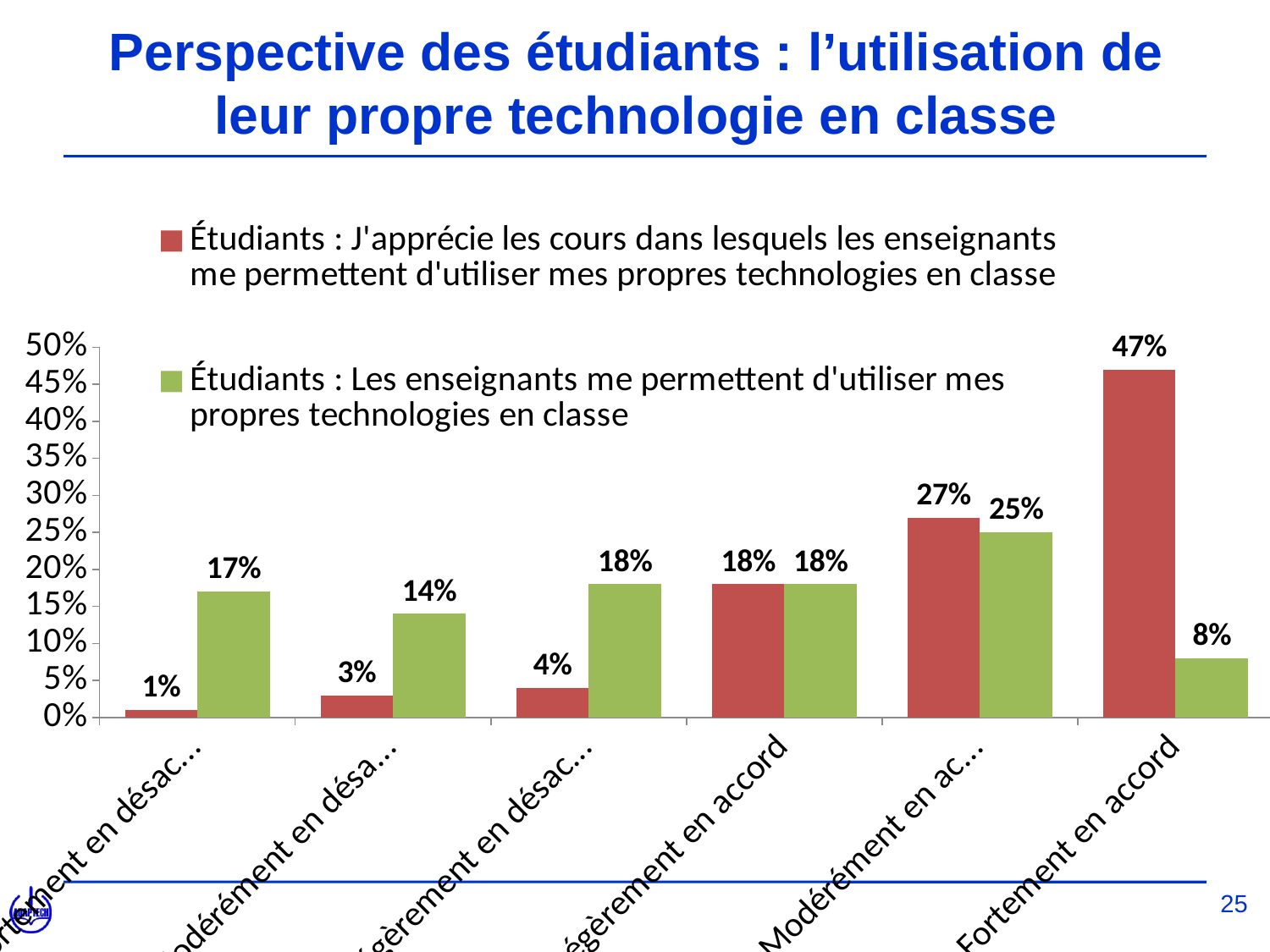
What type of chart is shown on the slide? bar chart What is the value for 'Fortement en accord' in the series 'Étudiants : J'apprécie les cours dans lesquels les enseignants me permettent d'utiliser mes propres technologies en classe'? 47% What is the highest value shown for the green series? 25% What is the value for 'Légèrement en accord' in the series 'Étudiants : J'apprécie les cours dans lesquels les enseignants me permettent d'utiliser mes propres technologies en classe'? 18% How many categories are shown along the x axis? 6 Do the values of the red series rise or fall from left to right along the x axis? rise For 'Fortement en accord', what is the difference between the red series value and the green series value? 39% How many series does the legend list? 2 What is the highest value shown for the red series? 47% What is the value for 'Fortement en accord' in the series 'Étudiants : Les enseignants me permettent d'utiliser mes propres technologies en classe'? 8% What is the lowest value shown for the red series? 1% For 'Fortement en accord', which series has the larger value? Étudiants : J'apprécie les cours dans lesquels les enseignants me permettent d'utiliser mes propres technologies en classe